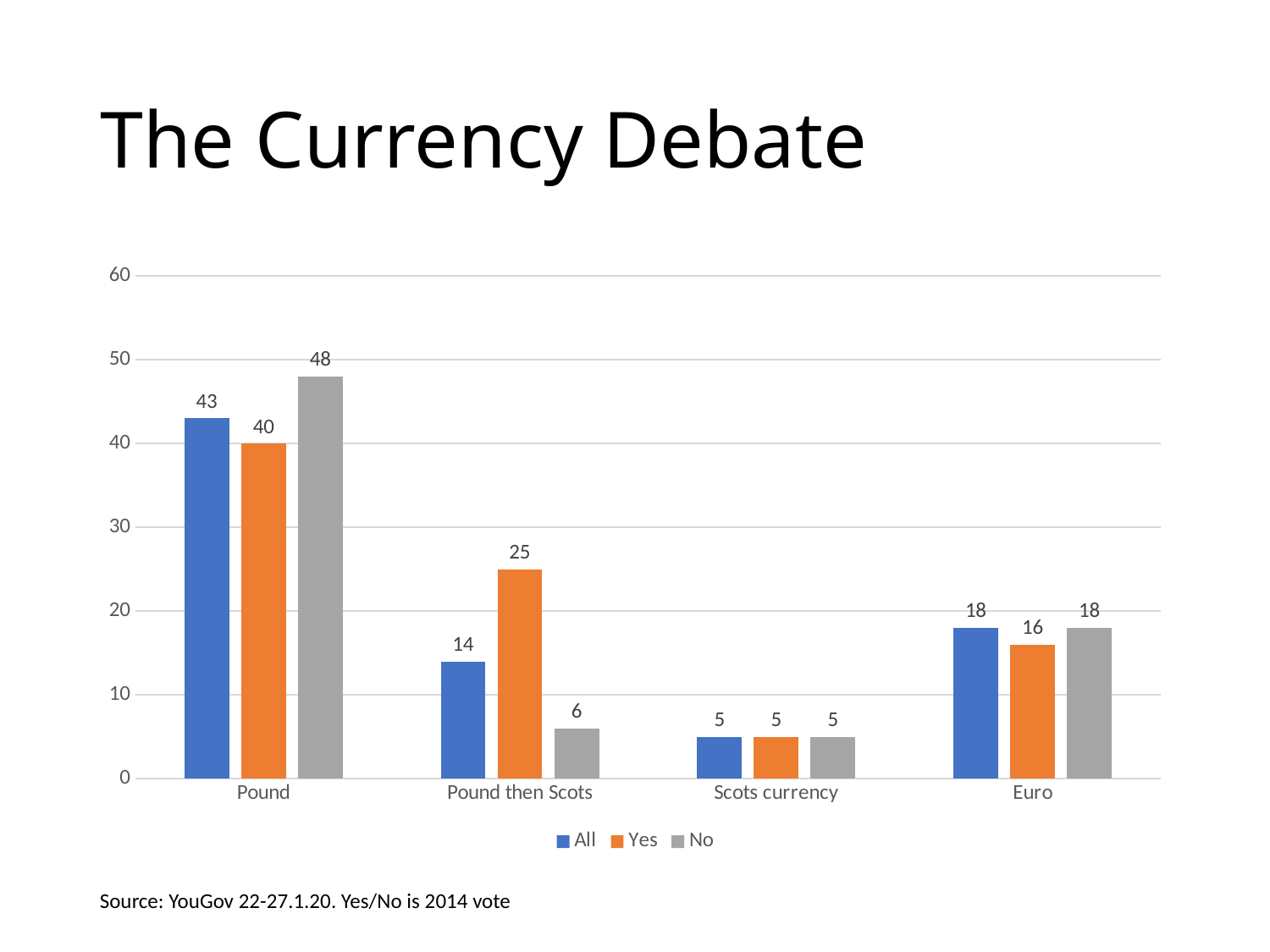
What is the title of the slide? The Currency Debate Which is larger in the Pound category: the 'All' value or the 'Yes' value? All What is the value for the 'No' series in the Pound category? 48 What is the difference between the 'Yes' and 'No' values in the Pound then Scots category? 19 Which category has the lowest value for the 'No' series? Scots currency What is the value for the 'All' series in the Euro category? 18 Which category has the highest value for the 'All' series? Pound What is the value for the 'Yes' series in the Pound then Scots category? 25 How many series does the legend list? 3 Is the value for 'No' in the Pound category greater or less than 40? greater How many categories are shown on the x axis? 4 What kind of chart is shown on the slide? Bar chart